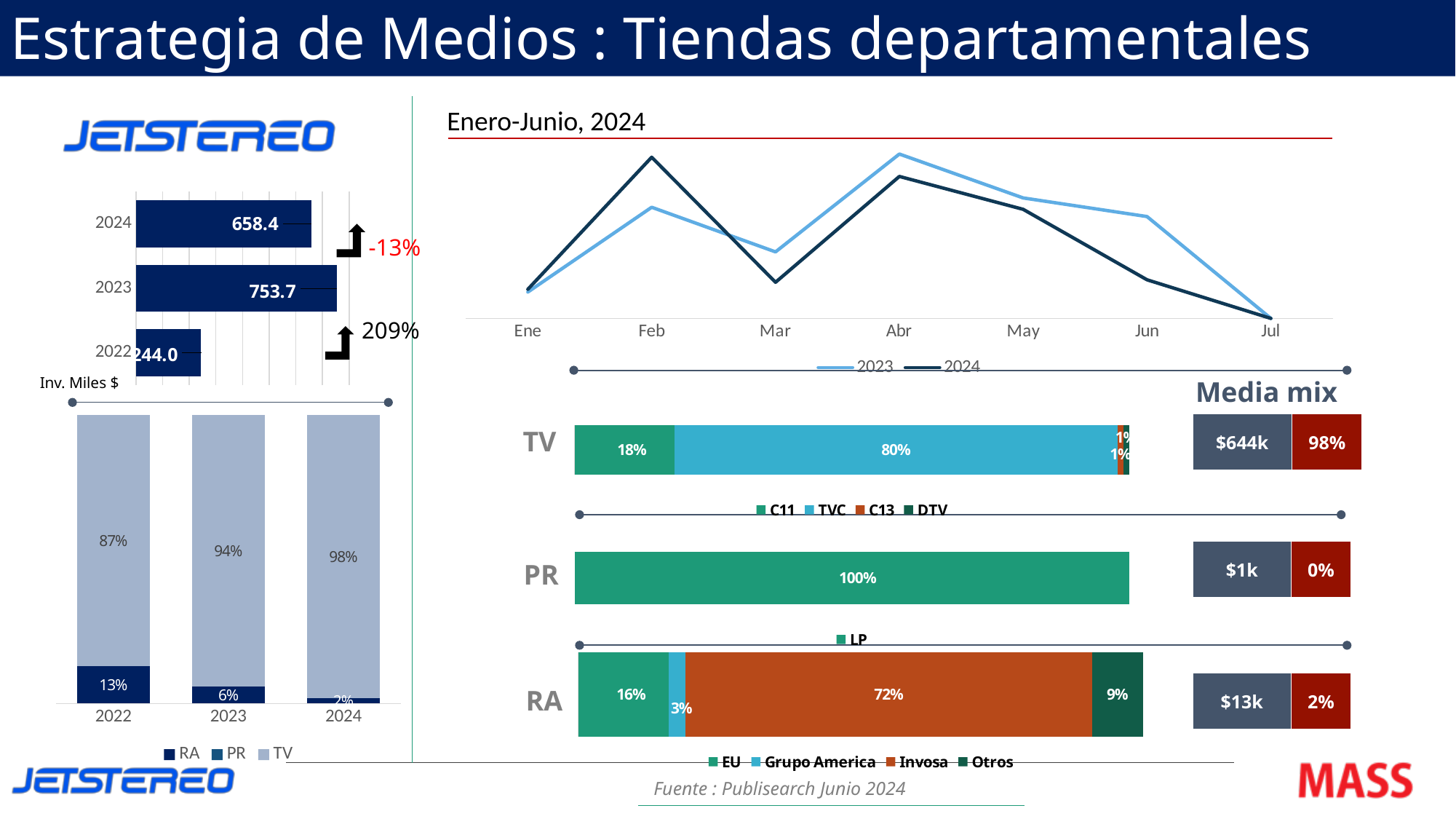
In the horizontal bar chart of investment (Inv. Miles $) on the left, what is the difference between the 2023 and 2024 values? 95.3 In the TV stacked bar chart, what is the share for TVC? 80% In the line chart titled 'Enero-Junio, 2024', how many months are shown on the x axis? 7 In the horizontal bar chart of investment (Inv. Miles $) on the left, what is the value for 2023? 753.7 In the Media mix boxes on the right, what is the dollar amount shown for TV? $644k In the horizontal bar chart of investment (Inv. Miles $) on the left, which year has the lowest value? 2022 In the line chart titled 'Enero-Junio, 2024', do the lines rise or fall from Jun to Jul? fall In the line chart titled 'Enero-Junio, 2024', in which month does the 2024 line reach its highest point? Feb In the stacked bar chart of media share by year at the bottom left, what is the TV share for 2023? 94% In the stacked bar chart of media share by year at the bottom left, how many series does the legend list? 3 In the RA stacked bar chart, what is the difference between the EU and Otros shares? 7% In the RA stacked bar chart, which supplier has the largest share? Invosa